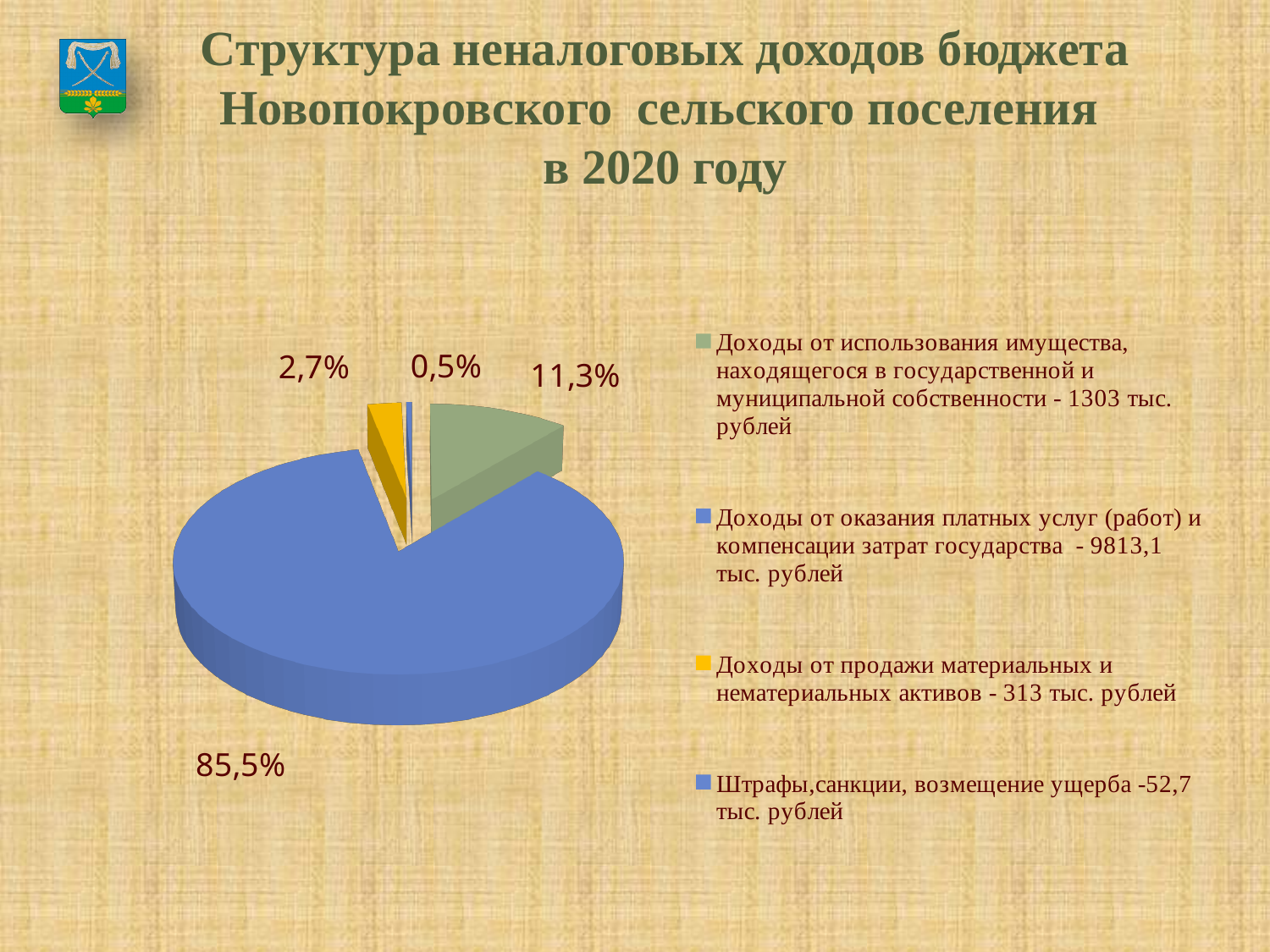
Which is larger: the share for 'Доходы от продажи материальных и нематериальных активов' or the share for 'Штрафы, санкции, возмещение ущерба'? Доходы от продажи материальных и нематериальных активов According to the legend, what is the amount in thousand rubles for 'Доходы от продажи материальных и нематериальных активов'? 313 тыс. рублей What share of the pie is labelled for 'Штрафы, санкции, возмещение ущерба'? 0,5% What is the difference in percentage points between the 85,5% slice and the 11,3% slice? 74,2 What share of the pie is labelled for 'Доходы от продажи материальных и нематериальных активов'? 2,7% Which category has the smallest slice of the pie? Штрафы, санкции, возмещение ущерба What share of the pie is labelled for 'Доходы от оказания платных услуг (работ) и компенсации затрат государства'? 85,5% How many slices does the pie chart have? 4 How many entries does the legend list? 4 Which category has the largest slice of the pie? Доходы от оказания платных услуг (работ) и компенсации затрат государства What kind of chart is shown on the slide? pie chart